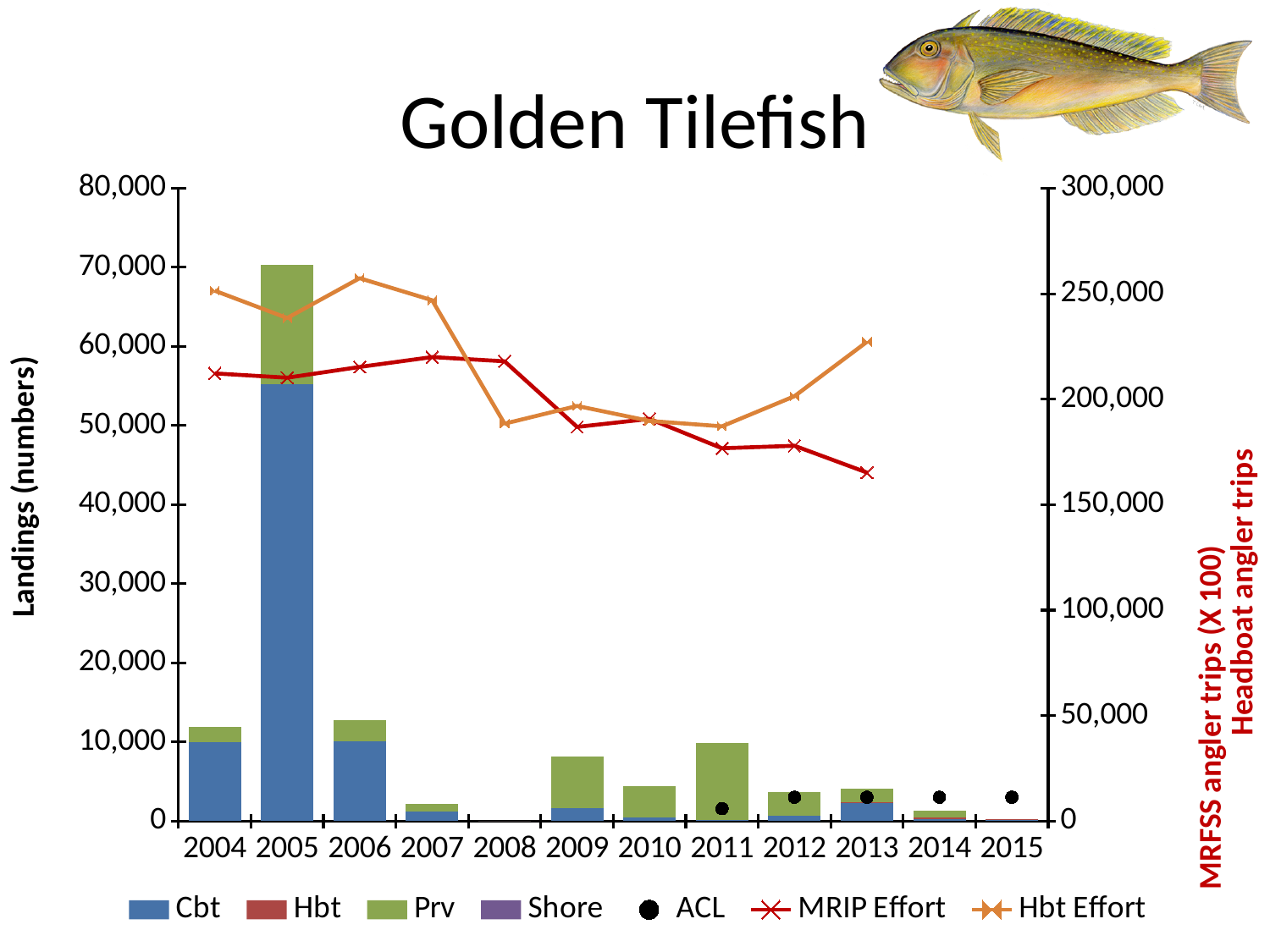
Which year has the highest total landings bar? 2005 How many series does the legend list? 7 Is the MRIP Effort value for 2013 greater or less than 200,000 on the right axis? less What is the title of the chart? Golden Tilefish How many years are shown on the x axis? 12 What kind of chart is used to show the landings data? stacked bar chart Is the total landings bar for 2005 greater or less than 60,000? greater Is the Hbt Effort value for 2004 greater or less than 200,000 on the right axis? greater Does the MRIP Effort line rise or fall from 2008 to 2013? fall Which year has the larger total landings bar, 2009 or 2010? 2009 Which year has the lowest MRIP Effort value? 2013